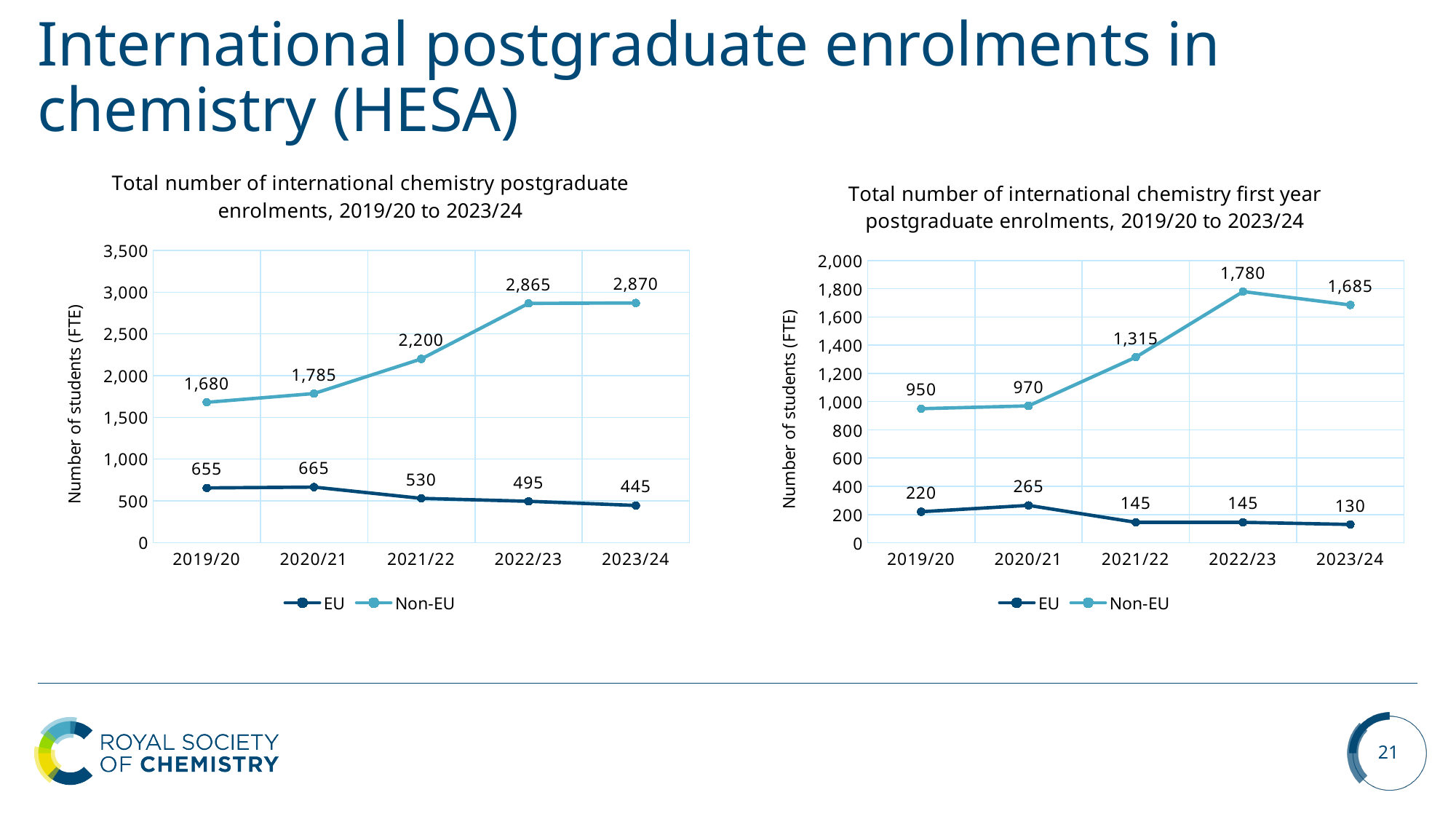
In the left chart (total international chemistry postgraduate enrolments), what is the Non-EU value for 2021/22? 2,200 In the right chart (first year postgraduate enrolments), what is the difference between the Non-EU values for 2022/23 and 2023/24? 95 In the right chart (first year postgraduate enrolments), what is the EU value for 2020/21? 265 In the left chart (total international chemistry postgraduate enrolments), what is the difference between the Non-EU and EU values in 2022/23? 2,370 In the left chart (total international chemistry postgraduate enrolments), what is the EU value for 2023/24? 445 In the right chart (first year postgraduate enrolments), what is the Non-EU value for 2022/23? 1,780 In the left chart (total international chemistry postgraduate enrolments), does the EU series rise or fall from 2020/21 to 2023/24? fall In the right chart (first year postgraduate enrolments), which year has the lowest EU value? 2023/24 In the right chart (first year postgraduate enrolments), which is larger: the EU value for 2019/20 or the EU value for 2020/21? 2020/21 How many series does the legend of the right chart (first year postgraduate enrolments) list? 2 In the left chart (total international chemistry postgraduate enrolments), which year has the highest Non-EU value? 2023/24 What type of chart is the left chart (total international chemistry postgraduate enrolments)? line chart